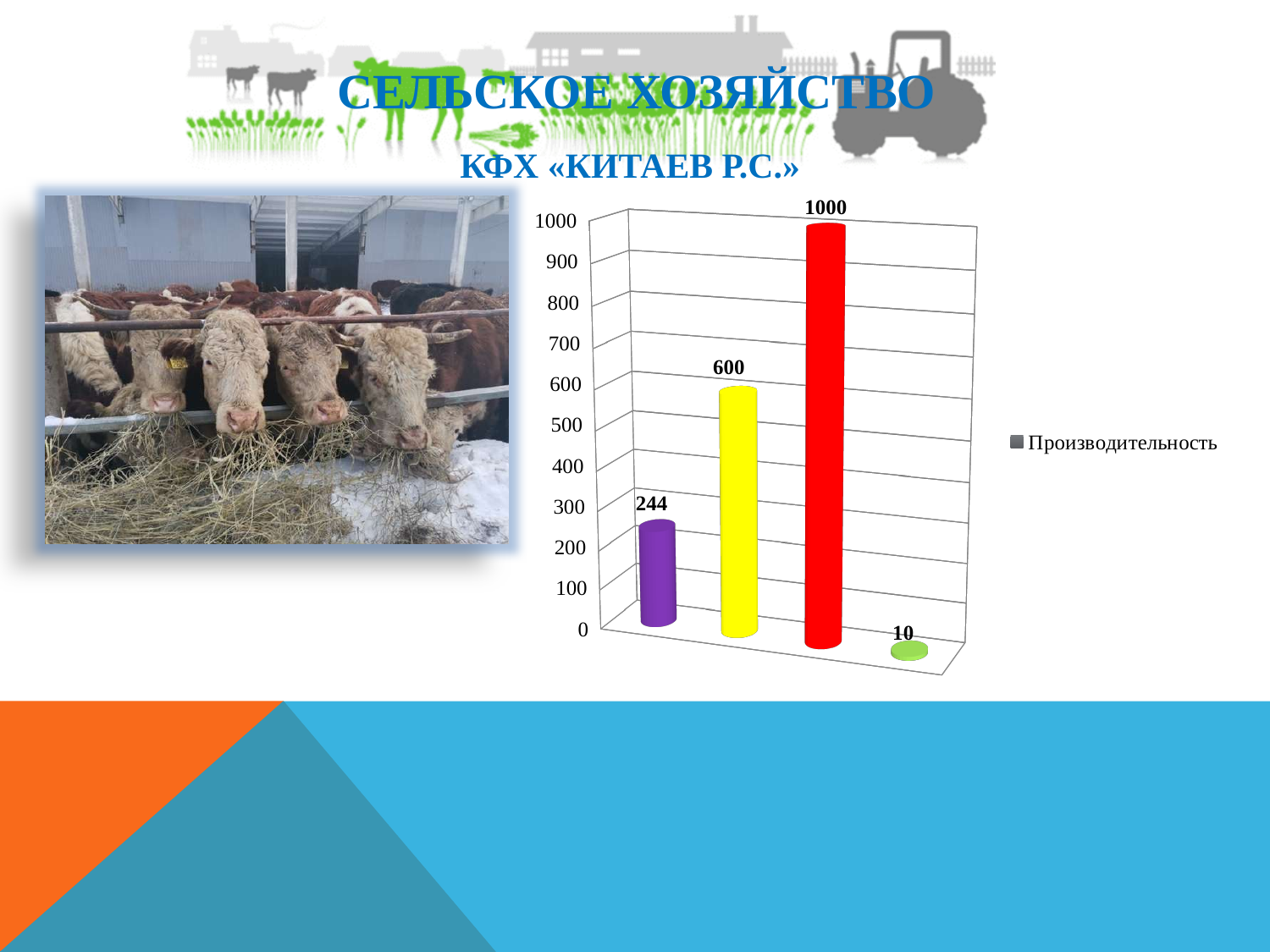
What is the value of the red bar in the chart? 1000 Which is larger in the chart, the purple bar or the yellow bar? the yellow bar What is the value of the green bar (last on the right) in the chart? 10 How many bars are plotted in the chart? 4 What is the difference between the red bar and the yellow bar in the chart? 400 Which bar has the highest value in the chart? the red bar (1000) What is the name of the series shown in the chart legend? Производительность What type of chart is shown on the slide? bar chart What is the value of the yellow bar in the chart? 600 What is the value of the purple bar (first from the left) in the chart? 244 Which bar has the lowest value in the chart? the green bar (10) How many series does the chart legend list? 1